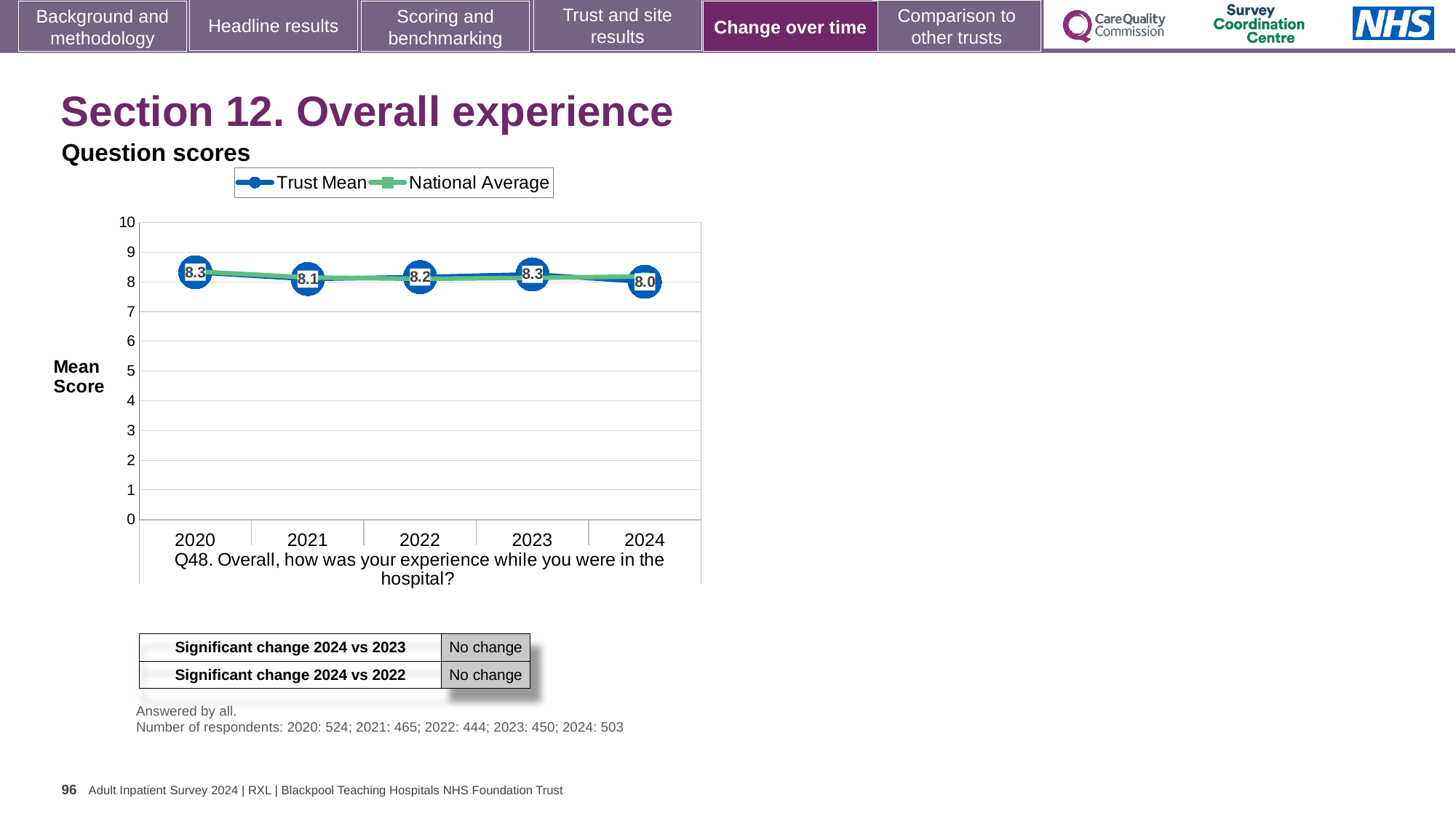
What is the Trust Mean score for 2022? 8.2 How many years are plotted on the x axis? 5 What is the Trust Mean score for 2024? 8.0 Does the Trust Mean score rise or fall from 2023 to 2024? fall What is the difference between the Trust Mean score in 2020 and in 2024? 0.3 What is the Trust Mean score for 2020? 8.3 What is the label on the y axis? Mean Score How many series does the legend list? 2 In which year is the Trust Mean score lowest? 2024 Which year has the higher Trust Mean score, 2023 or 2024? 2023 What kind of chart is shown? line chart Is the National Average value for 2020 greater or less than 5? greater